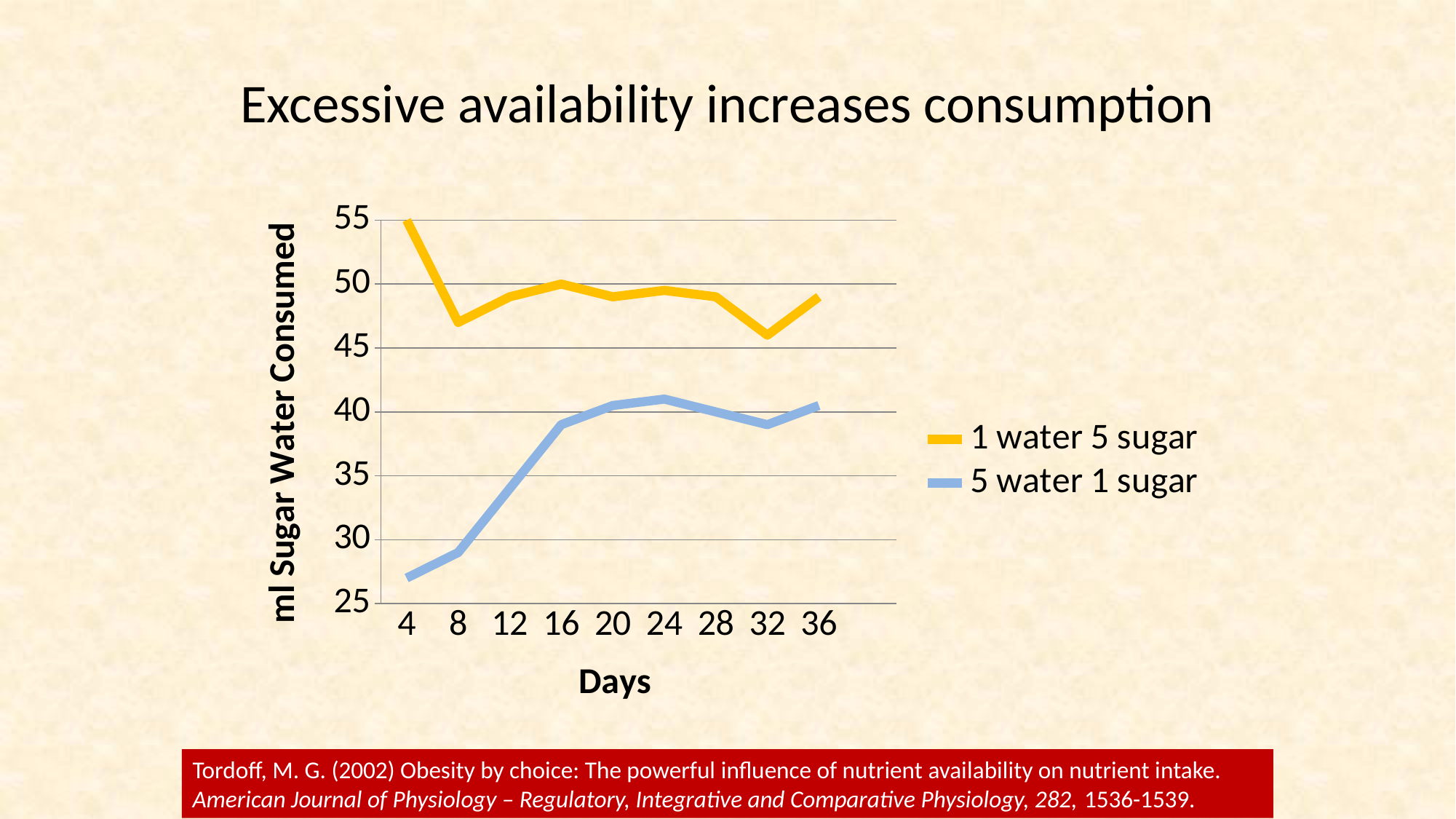
Is the value for 1 water 5 sugar at day 4 greater or less than 50? greater Is the value for 5 water 1 sugar at day 24 greater or less than 40? greater How many points along the Days axis are plotted for each series? 9 What is the label on the vertical axis of the chart? ml Sugar Water Consumed At day 4, which series has the higher value, 1 water 5 sugar or 5 water 1 sugar? 1 water 5 sugar At which day does the 5 water 1 sugar series have its lowest value? 4 Is the value for 1 water 5 sugar at day 32 greater or less than 50? less How many series does the legend list? 2 Does the 5 water 1 sugar series rise or fall between day 4 and day 16? rise What kind of chart is shown on the slide? line chart At which day does the 1 water 5 sugar series reach its highest value? 4